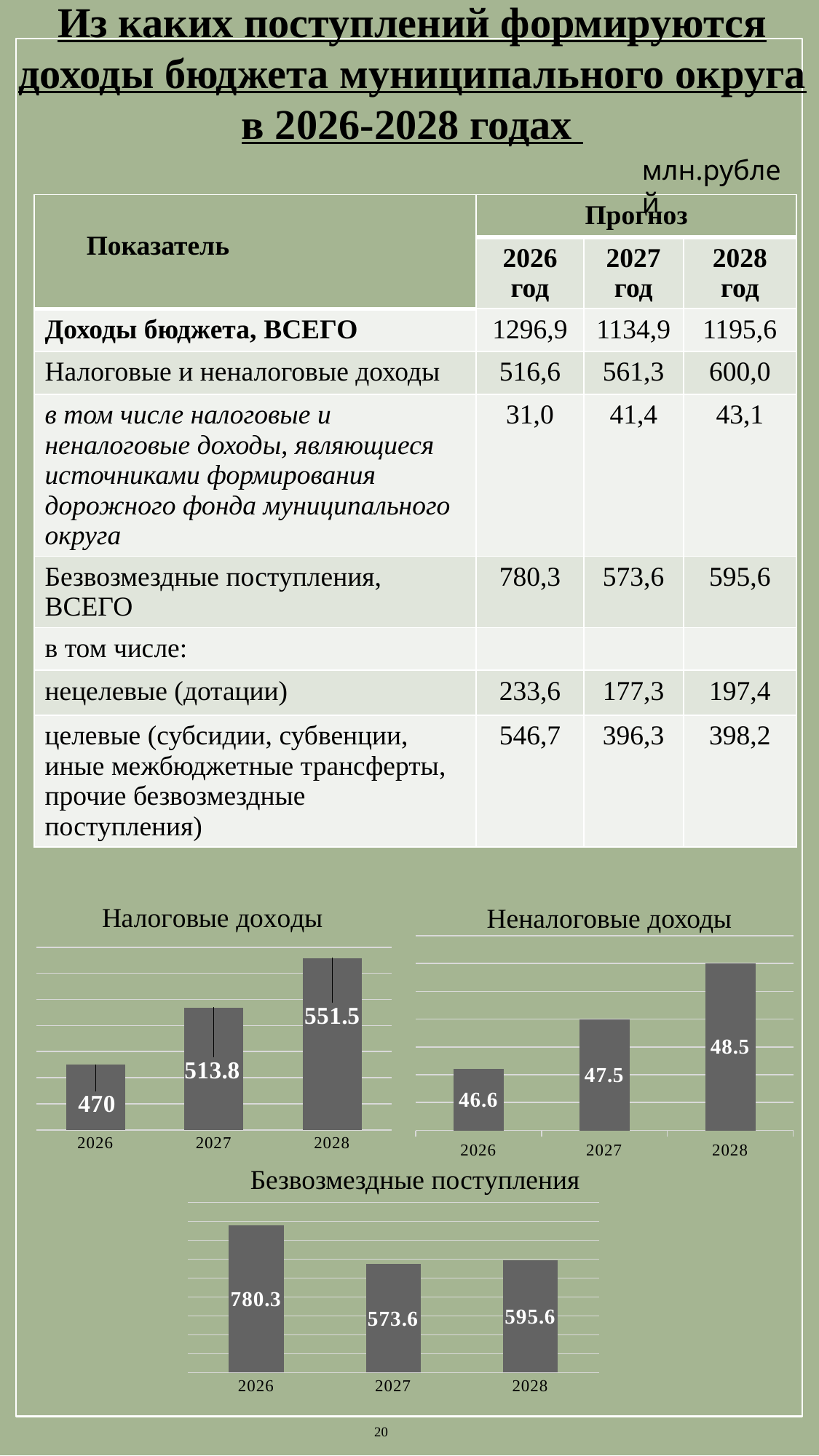
In the chart titled "Налоговые доходы", which year has the highest value? 2028 In the chart titled "Безвозмездные поступления", which is larger, the value for 2027 or the value for 2028? 2028 In the chart titled "Неналоговые доходы", what is the value for 2027? 47.5 In the chart titled "Неналоговые доходы", which year has the lowest value? 2026 In the chart titled "Налоговые доходы", what is the value for 2028? 551.5 In the chart titled "Безвозмездные поступления", which year has the lowest value? 2027 In the chart titled "Налоговые доходы", what is the difference between the 2028 and 2026 values? 81.5 In the chart titled "Налоговые доходы", what is the value for 2026? 470 In the chart titled "Налоговые доходы", do the values rise or fall from 2026 to 2028? rise In the chart titled "Неналоговые доходы", how many bars are plotted? 3 What kind of chart is the chart titled "Безвозмездные поступления"? bar chart In the chart titled "Безвозмездные поступления", what is the value for 2026? 780.3